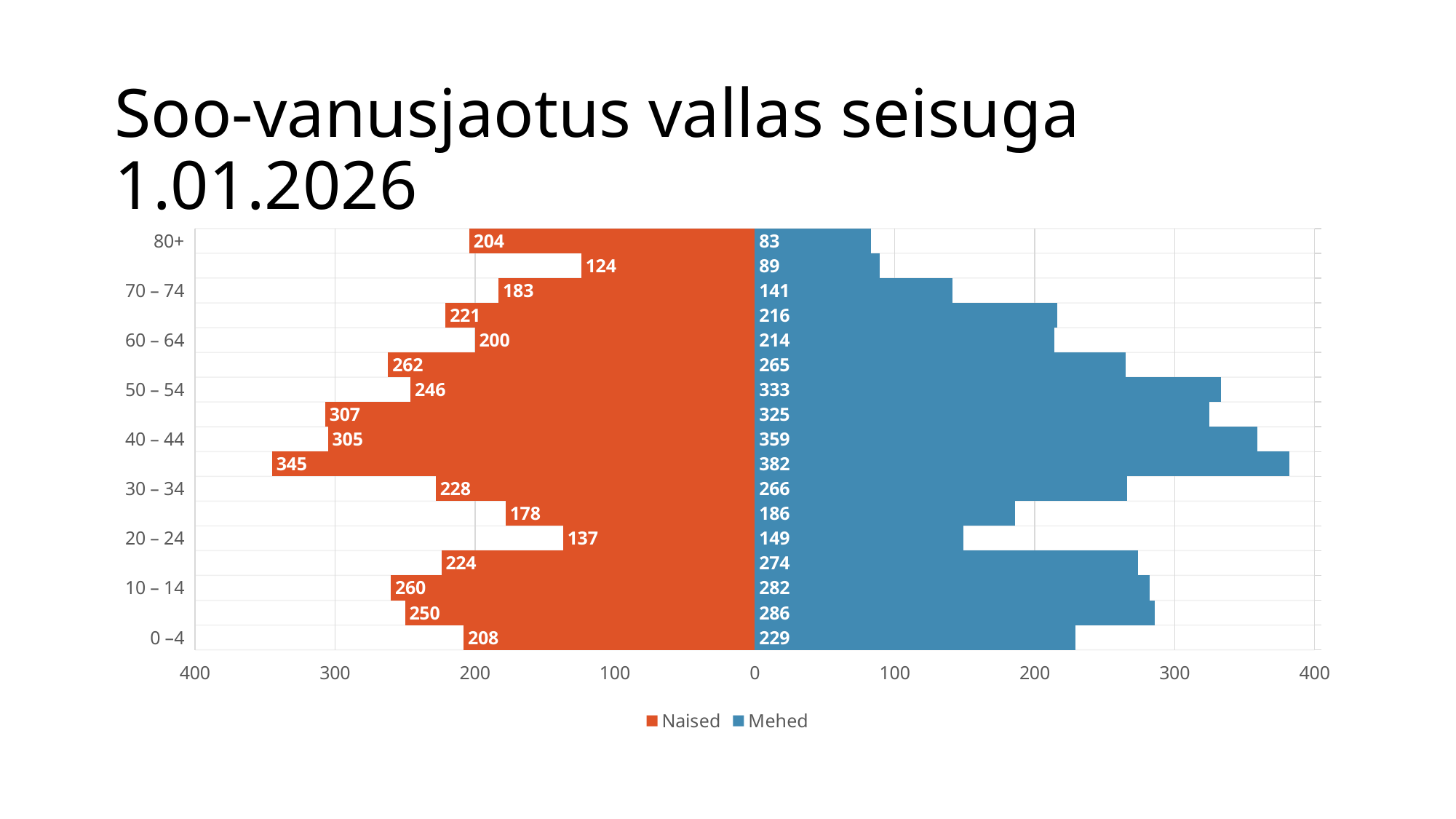
In the 30 – 34 age group, which series has the larger value, Naised or Mehed? Mehed What is the value for Naised in the 50 – 54 age group? 246 In the 80+ age group, which series has the larger value, Naised or Mehed? Naised In the 60 – 64 age group, how much larger is the Mehed value than the Naised value? 14 How many series does the legend list? 2 What is the value for Naised in the 80+ age group? 204 What is the value for Mehed in the 40 – 44 age group? 359 In the 10 – 14 age group, what is the difference between the Mehed and Naised values? 22 What is the value for Mehed in the 20 – 24 age group? 149 What is the combined total of Naised and Mehed in the 0 – 4 age group? 437 Which labelled age group has the lowest Mehed value? 80+ What kind of chart is shown on the slide? Bar chart